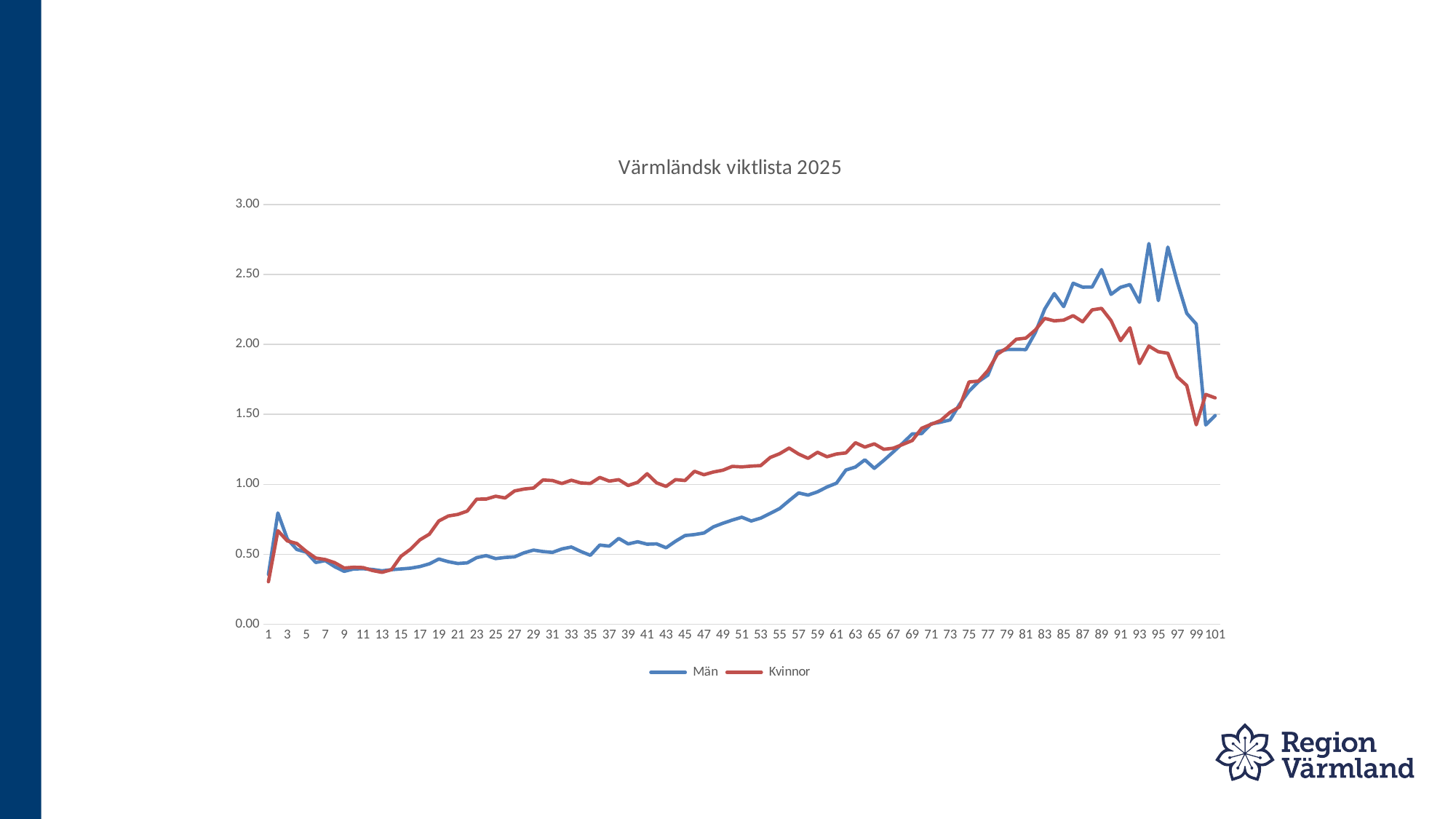
Is the value for Män at x = 20 greater or less than 0.50? less Which series is drawn in red? Kvinnor Is the value for Kvinnor at x = 20 greater or less than 1.00? less At x = 30, which series has the larger value, Män or Kvinnor? Kvinnor What kind of chart is shown on the slide? line chart Is the value for Kvinnor at x = 89 greater or less than 2.00? greater At x = 94, which series has the larger value, Män or Kvinnor? Män How many series does the legend list? 2 Does the Kvinnor line generally rise or fall between x = 13 and x = 89? rise What is the title of the chart? Värmländsk viktlista 2025